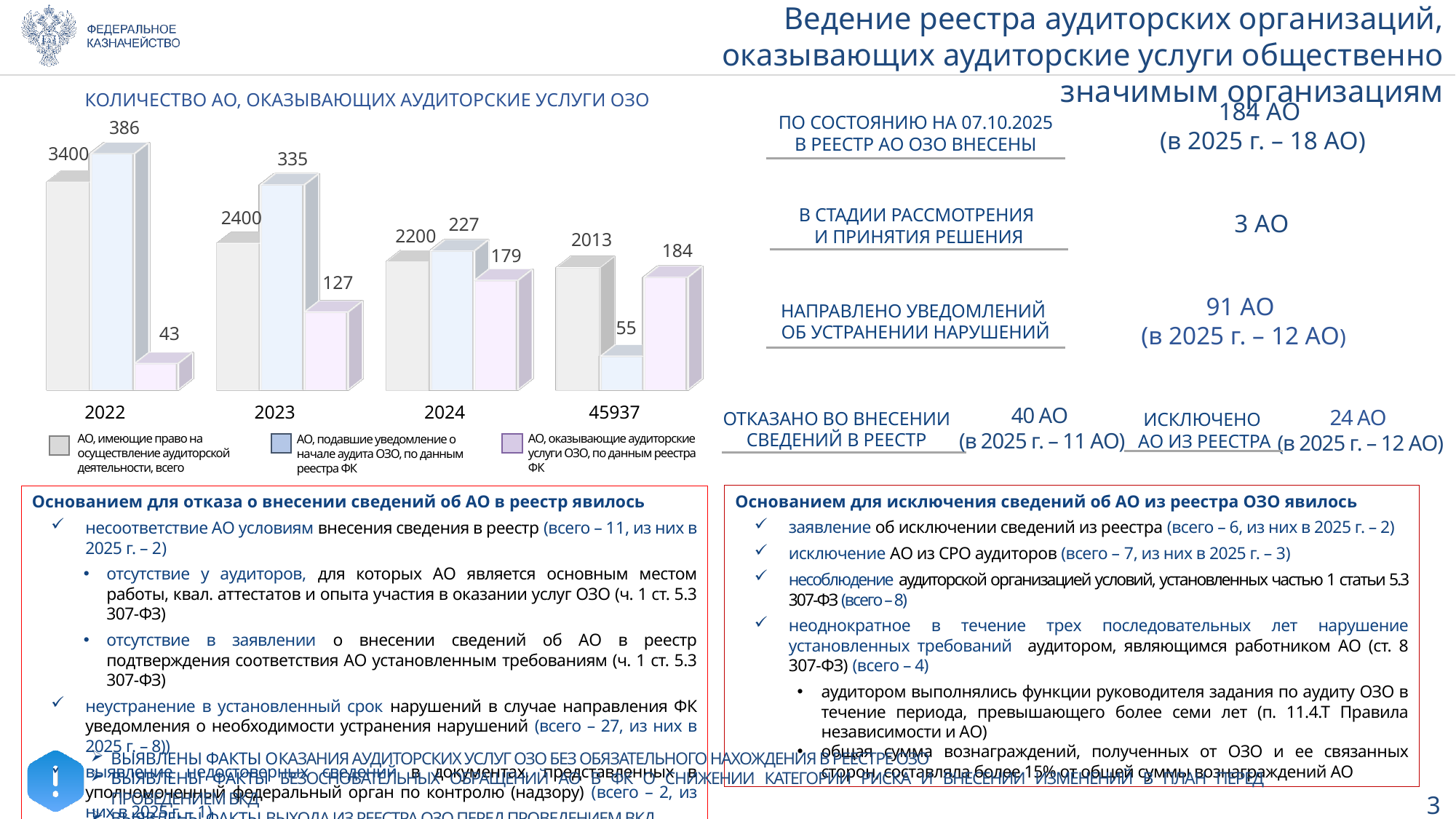
Do the values for the series 'АО, имеющие право на осуществление аудиторской деятельности, всего' rise or fall from 2022 to the last category? fall Which is larger: the 2023 value or the 2024 value for the series 'АО, подавшие уведомление о начале аудита ОЗО, по данным реестра ФК'? 2023 How many categories are shown on the x axis of the chart? 4 What is the value for the category labelled 45937 for the series 'АО, подавшие уведомление о начале аудита ОЗО, по данным реестра ФК'? 55 Which category has the lowest value for the series 'АО, имеющие право на осуществление аудиторской деятельности, всего'? 45937 What is the value for 2022 for the series 'АО, подавшие уведомление о начале аудита ОЗО, по данным реестра ФК'? 386 What kind of chart is shown on the slide? bar chart How many series does the chart legend list? 3 What is the value for 2023 for the series 'АО, имеющие право на осуществление аудиторской деятельности, всего'? 2400 Which category has the highest value for the series 'АО, оказывающие аудиторские услуги ОЗО, по данным реестра ФК'? 45937 What is the difference between the 2022 and 2023 values for the series 'АО, имеющие право на осуществление аудиторской деятельности, всего'? 1000 What is the value for 2024 for the series 'АО, оказывающие аудиторские услуги ОЗО, по данным реестра ФК'? 179